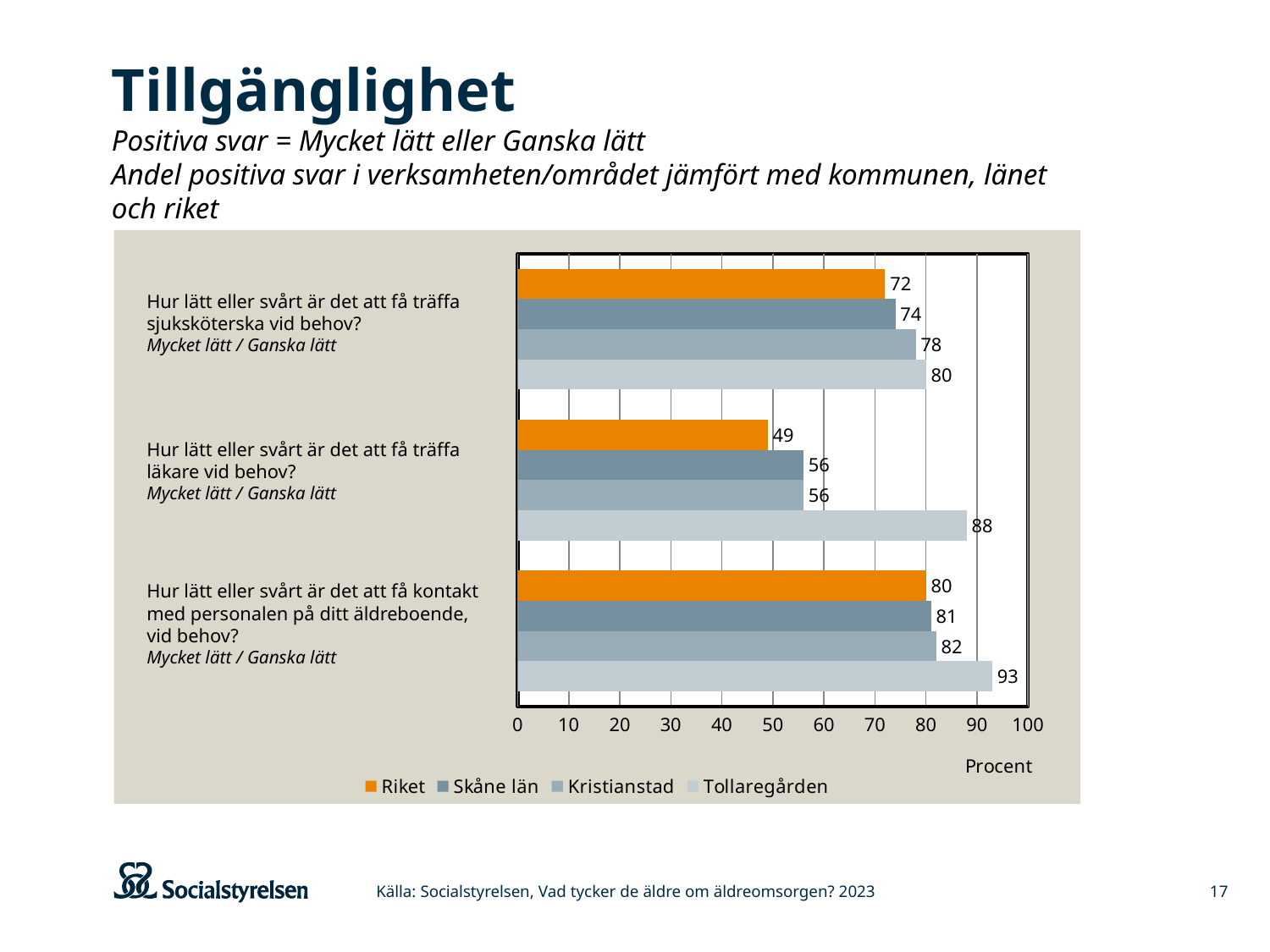
What unit label is shown below the x axis of the chart? Procent Which series has the lowest value for the question about getting to see a doctor (läkare) when needed? Riket What kind of chart is shown on the slide? Bar chart What is the difference between Tollaregården and Riket for the question about getting to see a doctor (läkare) when needed? 39 What is the value for Kristianstad for the question about getting in contact with staff at the care home when needed? 82 How many series does the legend list? 4 What is the difference between Tollaregården and Skåne län for the question about getting in contact with staff at the care home? 12 What is the value for Riket for the question about getting to see a nurse (sjuksköterska) when needed? 72 Which is larger for the question about getting to see a nurse (sjuksköterska): Skåne län or Kristianstad? Kristianstad What is the value for Tollaregården for the question about getting to see a doctor (läkare) when needed? 88 Which series has the highest value for the question about getting in contact with staff at the care home? Tollaregården How many question categories are plotted on the chart? 3